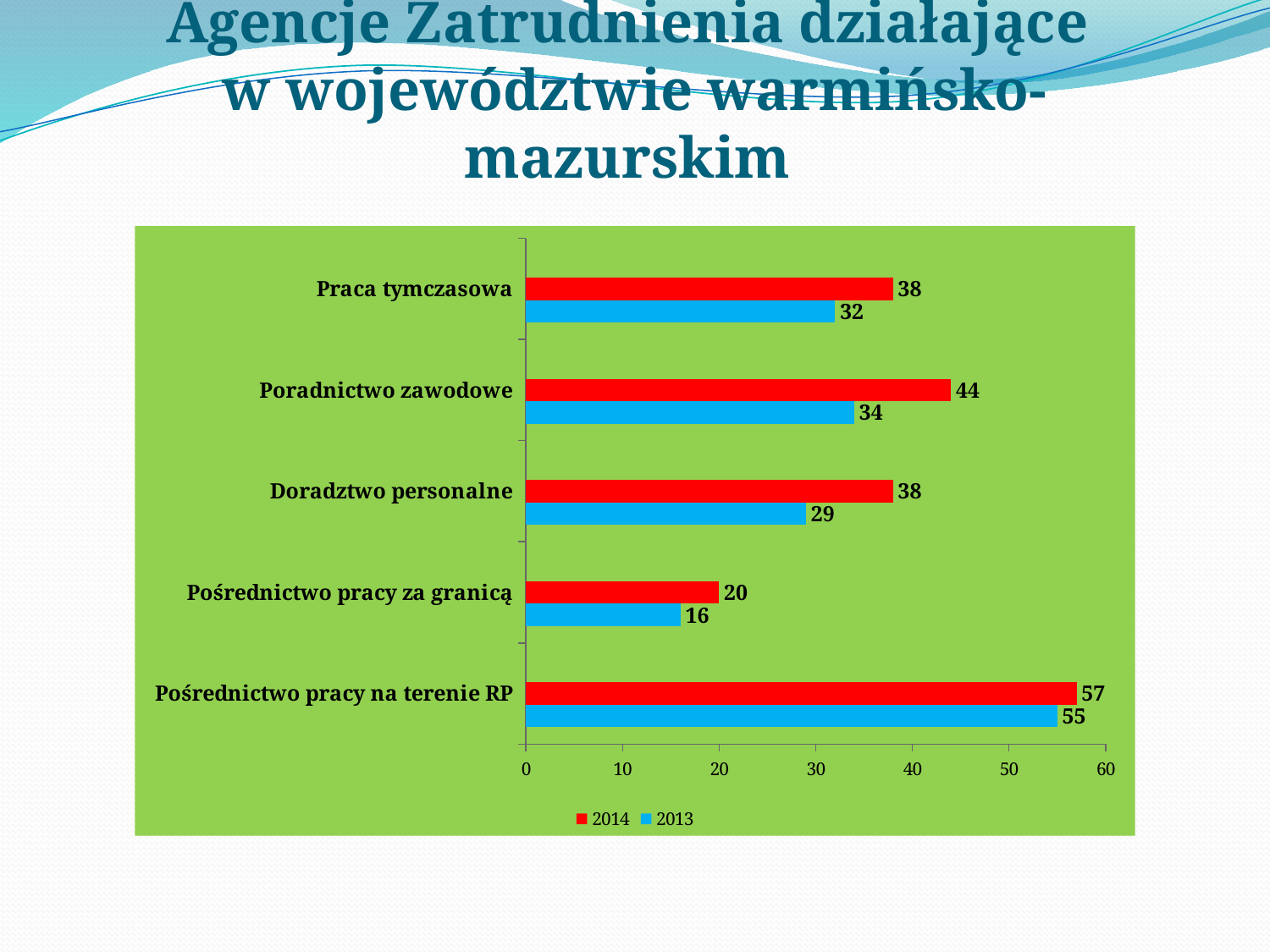
What is the difference between the 2014 and 2013 values for Poradnictwo zawodowe? 10 How many series does the legend list? 2 What is the 2014 value for Poradnictwo zawodowe? 44 What is the 2013 value for Pośrednictwo pracy za granicą? 16 How many categories are shown on the chart? 5 Which category has the highest 2014 value? Pośrednictwo pracy na terenie RP What is the 2013 value for Doradztwo personalne? 29 Which is larger: the 2014 value for Praca tymczasowa or the 2014 value for Poradnictwo zawodowe? Poradnictwo zawodowe What kind of chart is shown on the slide? Bar chart What is the difference between the 2014 and 2013 values for Pośrednictwo pracy na terenie RP? 2 Which category has the lowest 2013 value? Pośrednictwo pracy za granicą Which colour represents the 2013 series? Blue